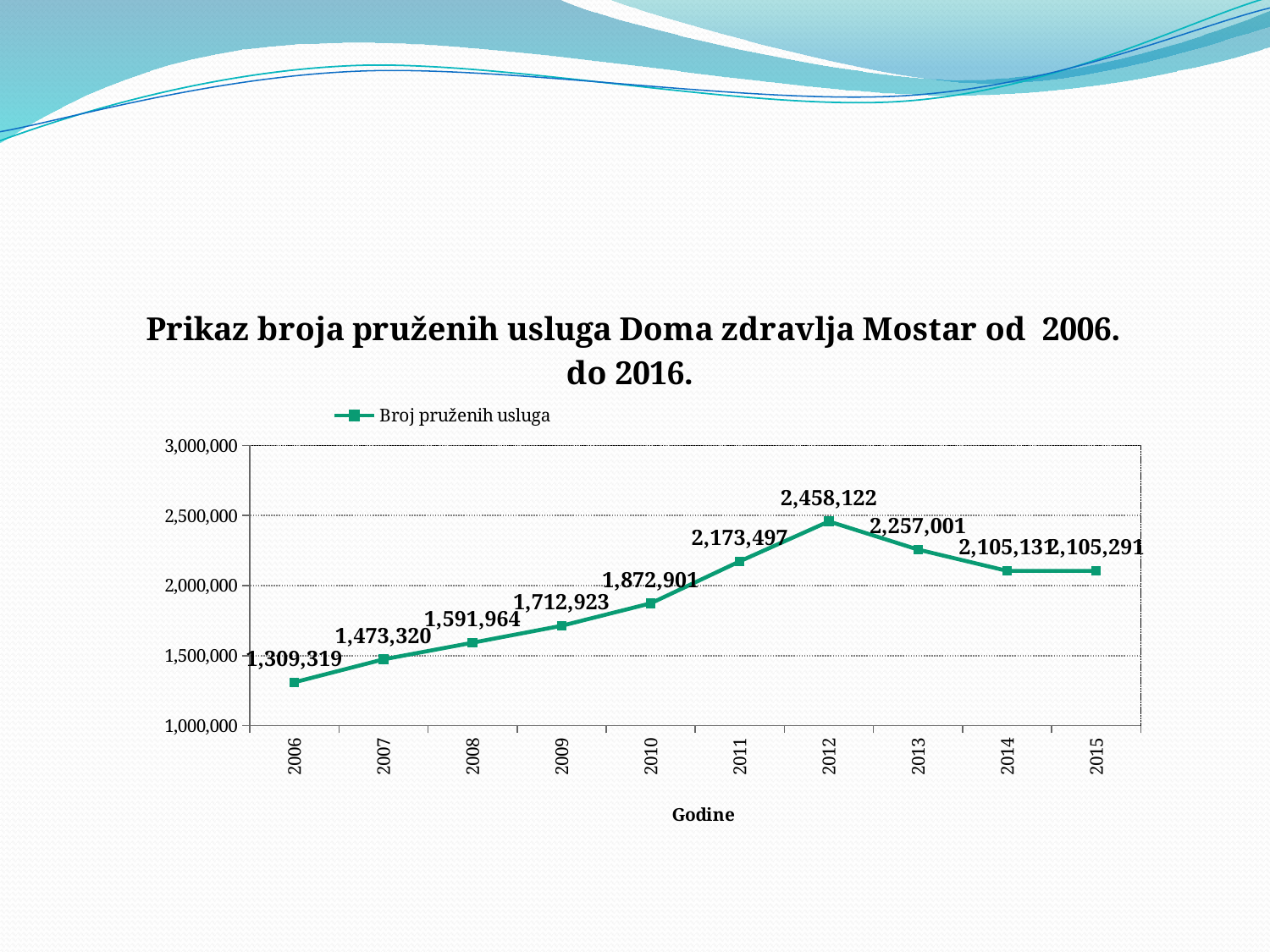
What is the value plotted for 2015? 2,105,291 Which year has the lowest number of services provided? 2006 What type of chart is shown on the slide? line chart How many years are plotted on the x axis? 10 What is the difference between the values for 2007 and 2006? 164,001 Is the value for 2010 greater or less than 2,000,000? less Which year has a larger value, 2013 or 2010? 2013 What is the value plotted for 2009? 1,712,923 What is the number of services provided (Broj pruženih usluga) in 2012? 2,458,122 Which year has the highest number of services provided? 2012 What is the value plotted for 2006? 1,309,319 What is the difference between the values for 2012 and 2011? 284,625